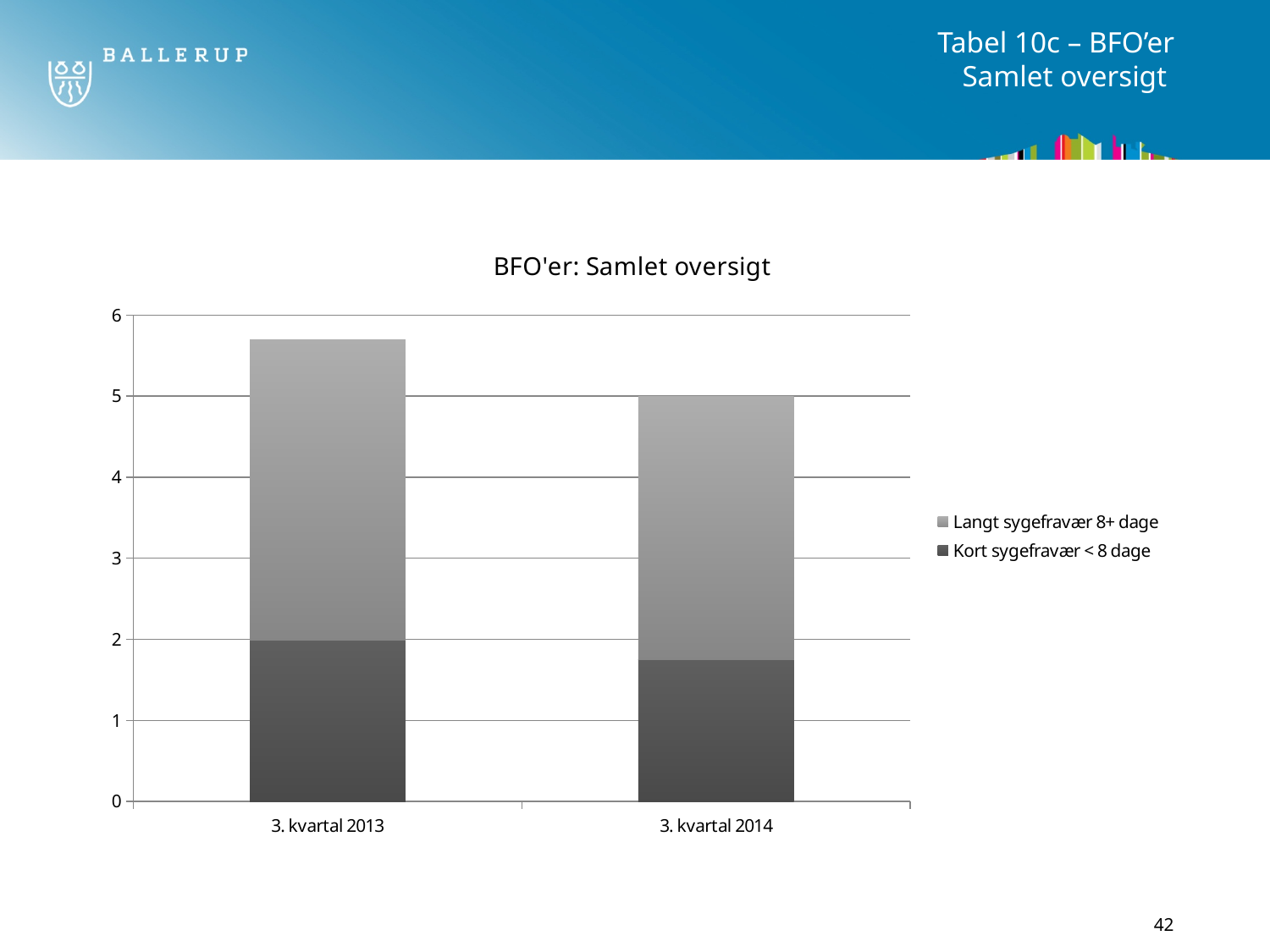
Is the value for Langt sygefravær 8+ dage in 3. kvartal 2013 greater or less than 3? greater Does the total stacked bar height rise or fall from 3. kvartal 2013 to 3. kvartal 2014? Fall What kind of chart is shown on the slide? Stacked bar chart Is the value for Kort sygefravær < 8 dage in 3. kvartal 2014 greater or less than 2? less How many series does the legend list? 2 What is the title of the chart? BFO'er: Samlet oversigt Which quarter has the larger value for Kort sygefravær < 8 dage? 3. kvartal 2013 How many categories are shown on the x axis? 2 Which quarter has the higher total stacked bar, 3. kvartal 2013 or 3. kvartal 2014? 3. kvartal 2013 Which series is shown in the darker colour at the bottom of each bar? Kort sygefravær < 8 dage What is the total height of the stacked bar for 3. kvartal 2014? 5 Is the total of the stacked bar for 3. kvartal 2013 greater or less than 5? greater